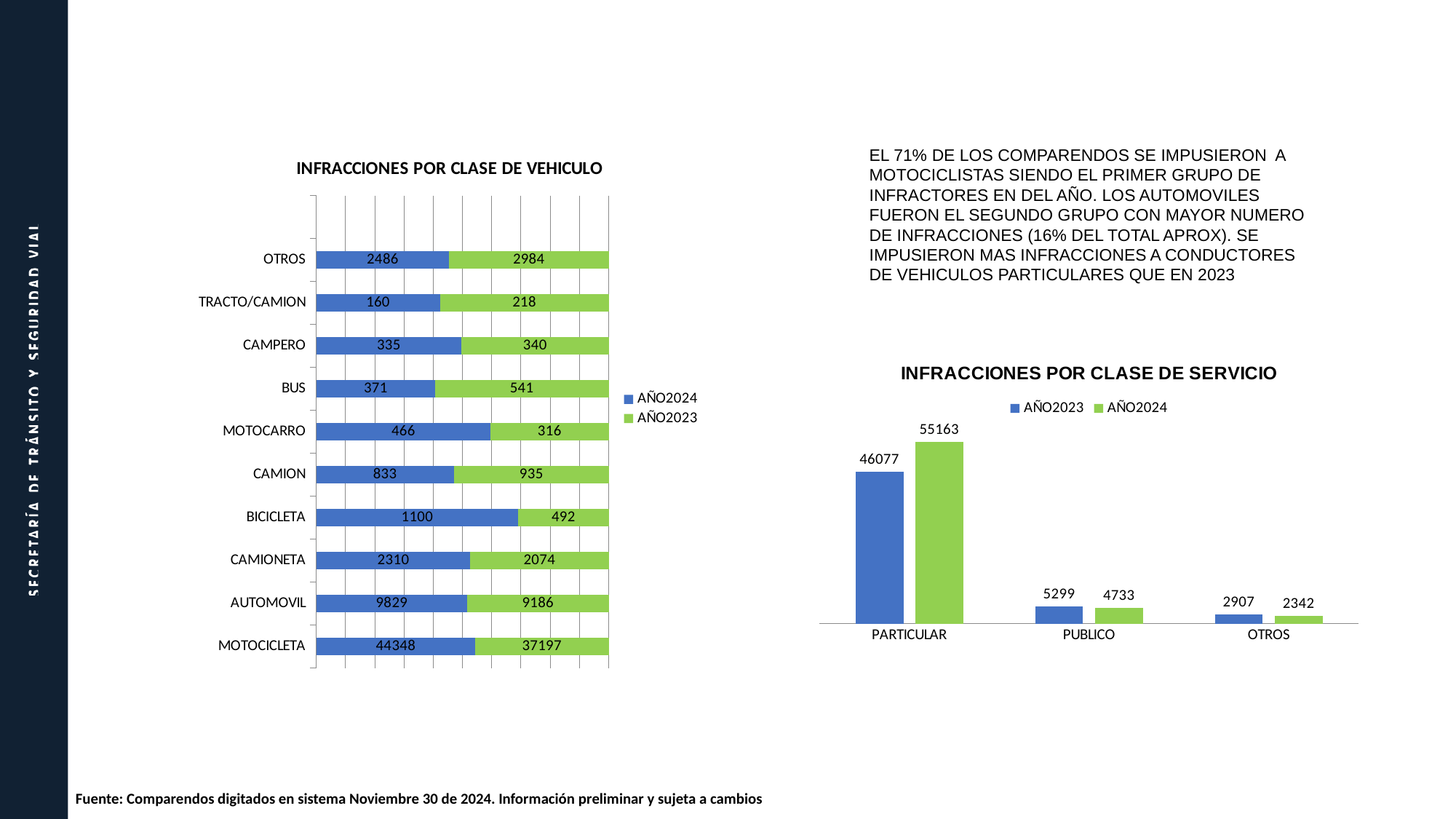
In the chart 'INFRACCIONES POR CLASE DE SERVICIO', what is the AÑO2023 value for PUBLICO? 5299 In the chart 'INFRACCIONES POR CLASE DE VEHICULO', what is the AÑO2023 value for BICICLETA? 492 In the chart 'INFRACCIONES POR CLASE DE VEHICULO', which is larger for BUS: the AÑO2024 value or the AÑO2023 value? AÑO2023 In the chart 'INFRACCIONES POR CLASE DE SERVICIO', what is the AÑO2024 value for PARTICULAR? 55163 In the chart 'INFRACCIONES POR CLASE DE SERVICIO', what is the difference between the AÑO2023 and AÑO2024 values for OTROS? 565 How many vehicle categories are shown in the chart 'INFRACCIONES POR CLASE DE VEHICULO'? 10 What type of chart is 'INFRACCIONES POR CLASE DE SERVICIO'? Bar chart In the chart 'INFRACCIONES POR CLASE DE VEHICULO', what is the AÑO2024 value for MOTOCICLETA? 44348 In the chart 'INFRACCIONES POR CLASE DE VEHICULO', what is the difference between the AÑO2024 and AÑO2023 values for AUTOMOVIL? 643 How many series does the legend list in the chart 'INFRACCIONES POR CLASE DE SERVICIO'? 2 In the chart 'INFRACCIONES POR CLASE DE VEHICULO', which category has the lowest AÑO2024 value? TRACTO/CAMION In the chart 'INFRACCIONES POR CLASE DE VEHICULO', which category has the highest AÑO2024 value? MOTOCICLETA